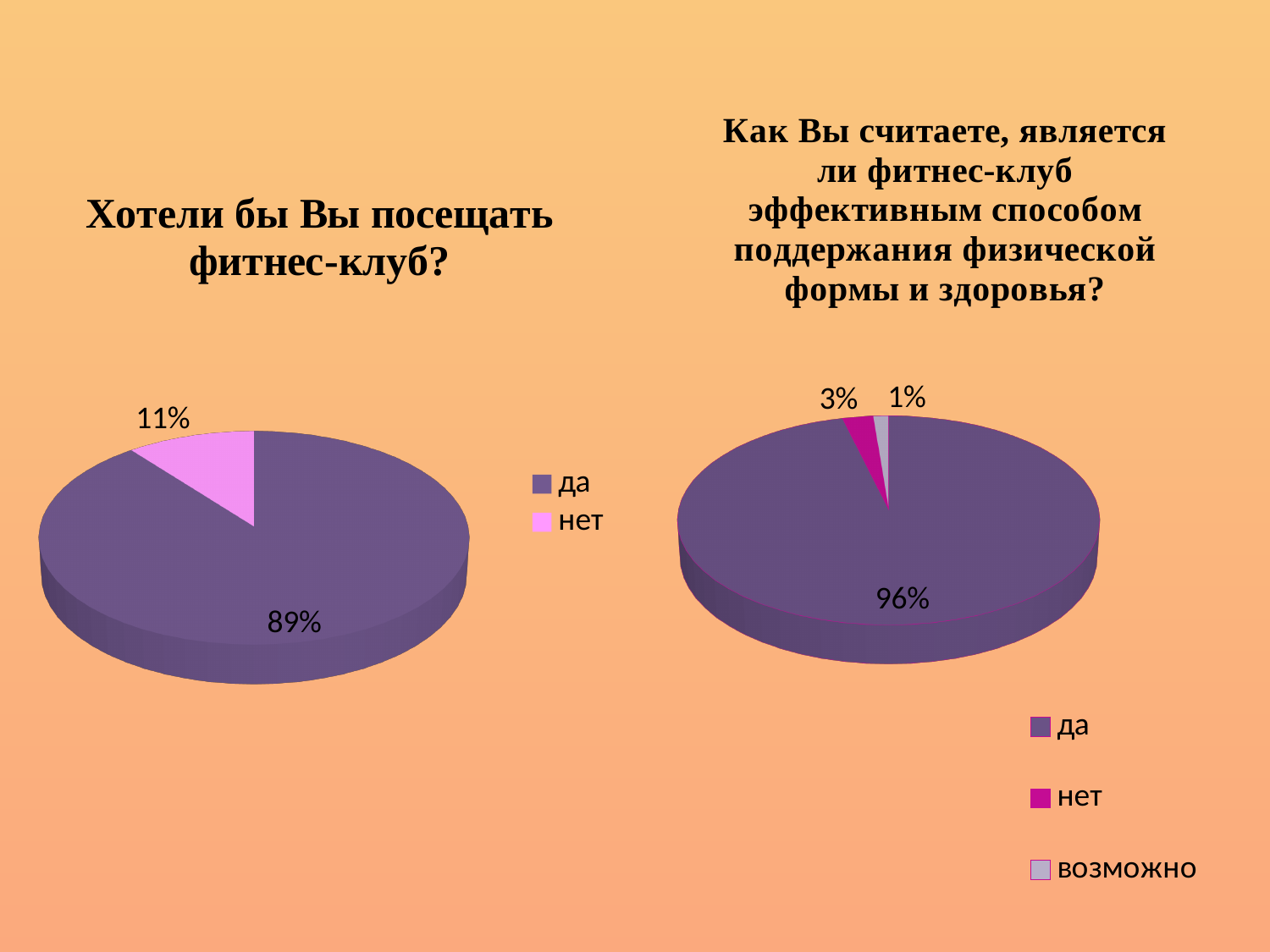
In the right pie chart ("Как Вы считаете, является ли фитнес-клуб эффективным способом..."), which category has the smallest slice? возможно What type of chart is the left chart ("Хотели бы Вы посещать фитнес-клуб?")? Pie chart In the right pie chart ("Как Вы считаете, является ли фитнес-клуб эффективным способом..."), what share is labelled for "да"? 96% In the right pie chart ("Как Вы считаете, является ли фитнес-клуб эффективным способом..."), which is larger, the "нет" slice or the "возможно" slice? нет In the left pie chart ("Хотели бы Вы посещать фитнес-клуб?"), which category has the largest slice? да In the left pie chart ("Хотели бы Вы посещать фитнес-клуб?"), how many categories does the legend list? 2 In the right pie chart ("Как Вы считаете, является ли фитнес-клуб эффективным способом..."), what share is labelled for "нет"? 3% In the left pie chart ("Хотели бы Вы посещать фитнес-клуб?"), what share is labelled for "да"? 89% In the left pie chart ("Хотели бы Вы посещать фитнес-клуб?"), what share is labelled for "нет"? 11% In the right pie chart ("Как Вы считаете, является ли фитнес-клуб эффективным способом..."), what share is labelled for "возможно"? 1% In the left pie chart ("Хотели бы Вы посещать фитнес-клуб?"), what is the difference between the "да" and "нет" shares? 78% In the right pie chart ("Как Вы считаете, является ли фитнес-клуб эффективным способом..."), how many categories does the legend list? 3